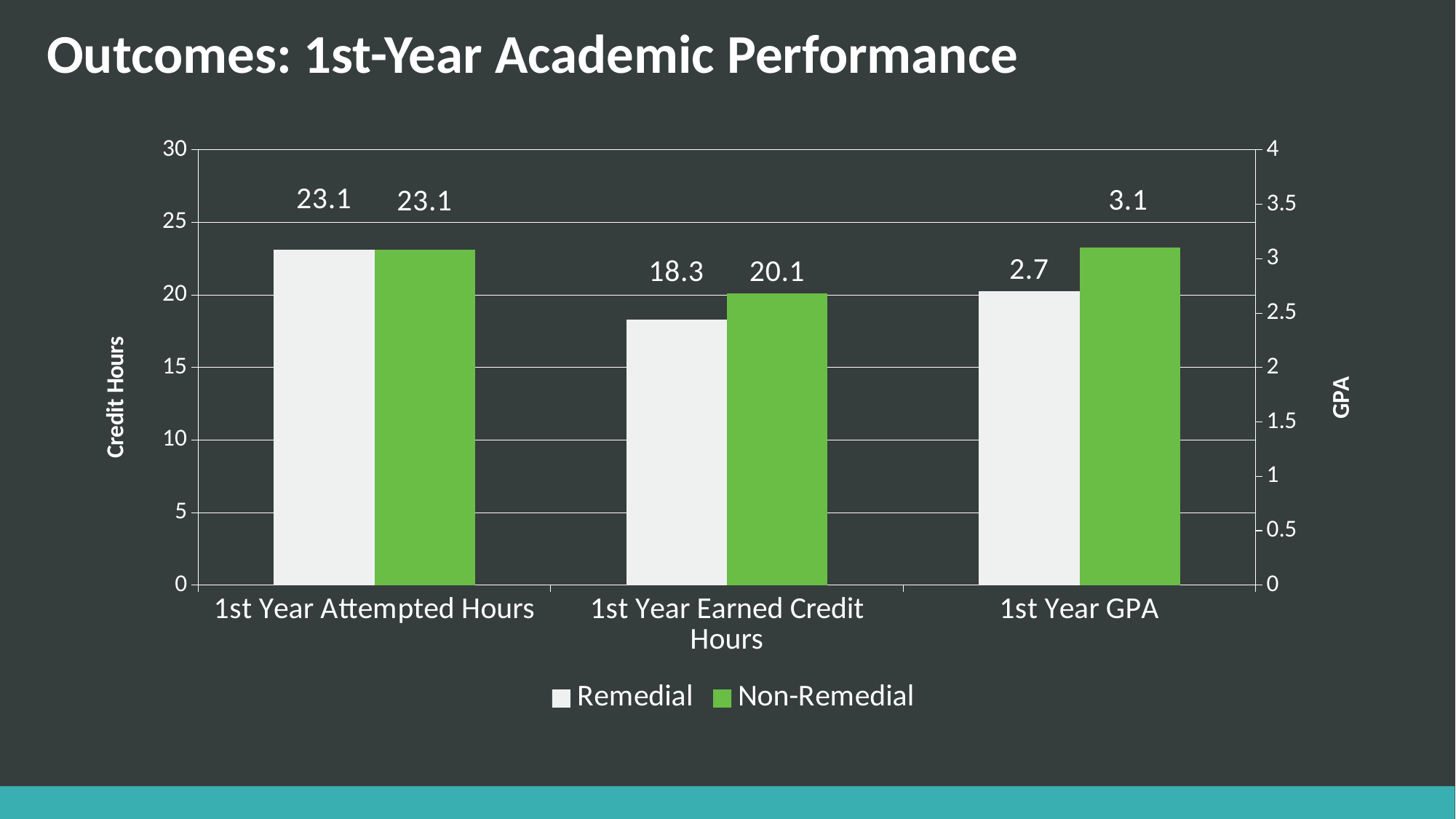
What is the value for Remedial in 1st Year Attempted Hours? 23.1 How many categories are shown on the x axis? 3 What is the difference between the Non-Remedial and Remedial 1st Year GPA? 0.4 What is the value for Remedial in 1st Year Earned Credit Hours? 18.3 How many series does the legend list? 2 Which group has the higher 1st Year GPA, Remedial or Non-Remedial? Non-Remedial What is the 1st Year GPA for the Remedial group? 2.7 What is the difference between Non-Remedial and Remedial in 1st Year Earned Credit Hours? 1.8 What is the value for Non-Remedial in 1st Year Earned Credit Hours? 20.1 What kind of chart is shown on the slide? Bar chart What is the 1st Year GPA for the Non-Remedial group? 3.1 Which group has the higher 1st Year Earned Credit Hours, Remedial or Non-Remedial? Non-Remedial